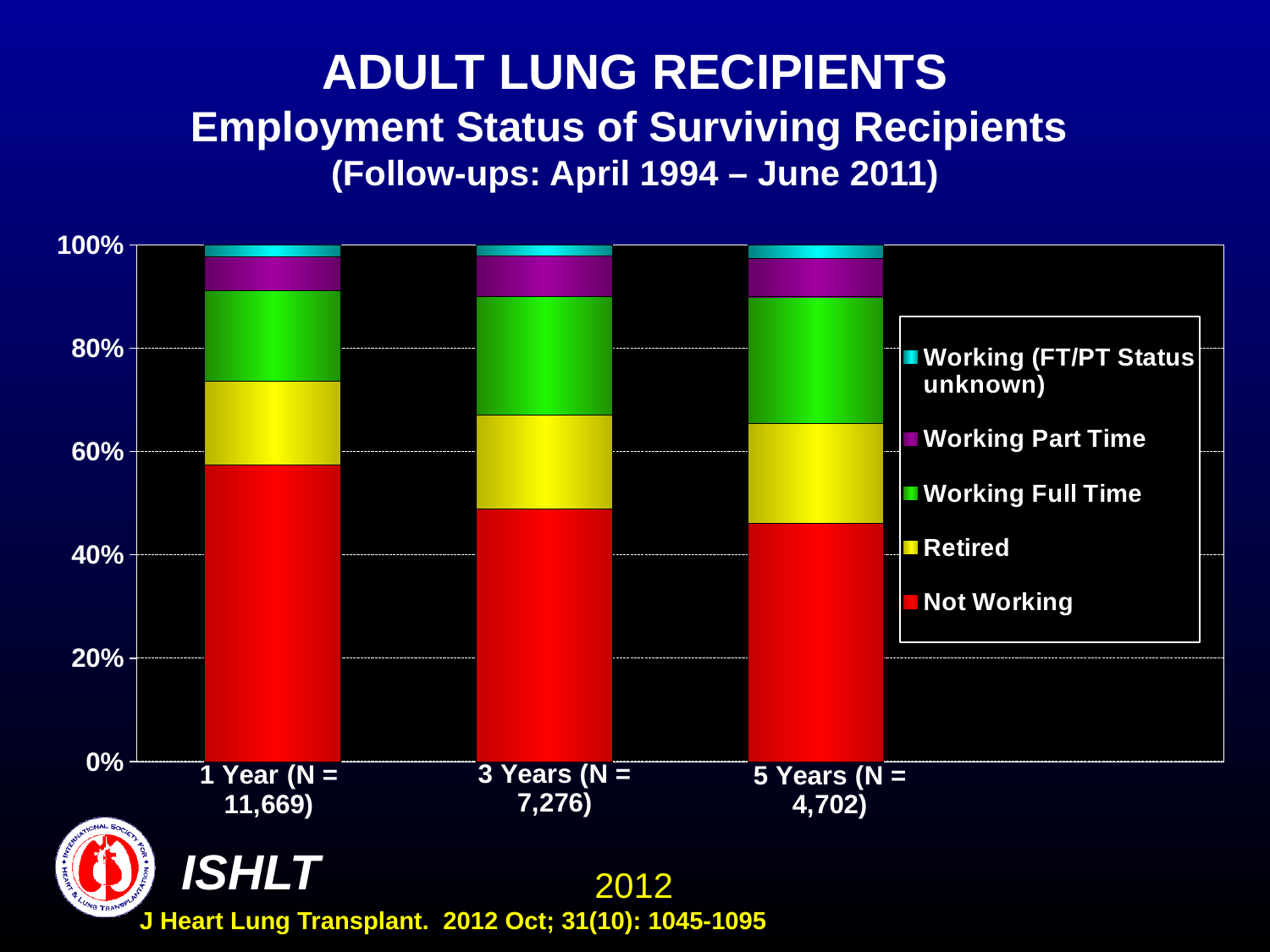
Which follow-up time has the smallest Not Working share? 5 Years (N = 4,702) Which follow-up time has the largest Not Working share? 1 Year (N = 11,669) Does the Not Working share rise or fall from 1 Year to 5 Years? Fall How many series does the legend list? 5 What colour represents Retired in the chart? Yellow Is the Not Working share at 5 Years greater or less than 60%? less Is the Not Working share at 1 Year greater or less than 40%? greater What is the N value shown for the 3 Years category? 7,276 Is the Not Working share larger at 1 Year or at 5 Years? 1 Year How many follow-up time categories are shown on the x axis? 3 Is the Not Working share at 3 Years greater or less than 60%? less What kind of chart is shown on the slide? Stacked bar chart